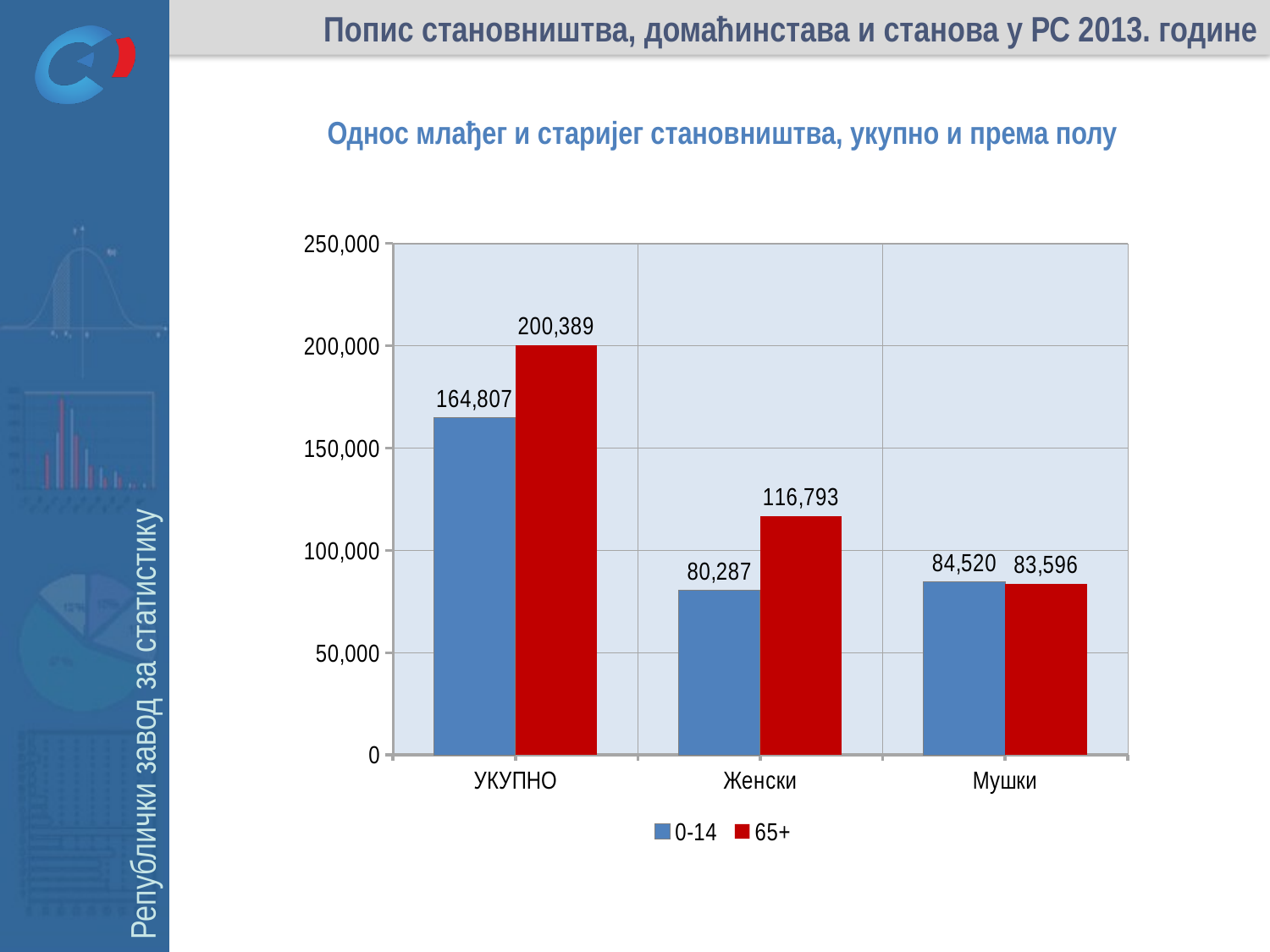
What is the value for the 0-14 series in the Мушки category? 84,520 In the Женски category, which series has the larger value, 0-14 or 65+? 65+ What is the value for the 65+ series in the Женски category? 116,793 Which category has the lowest value for the 0-14 series? Женски What is the value for the 0-14 series in the УКУПНО category? 164,807 Is the value for the 65+ series in the Мушки category greater or less than 100,000? less What is the difference between the 65+ and 0-14 values in the УКУПНО category? 35,582 How many series does the legend list? 2 What is the difference between the 65+ and 0-14 values in the Женски category? 36,506 How many categories are shown on the x axis? 3 What kind of chart is shown on the slide? bar chart Which category has the highest value for the 65+ series? УКУПНО